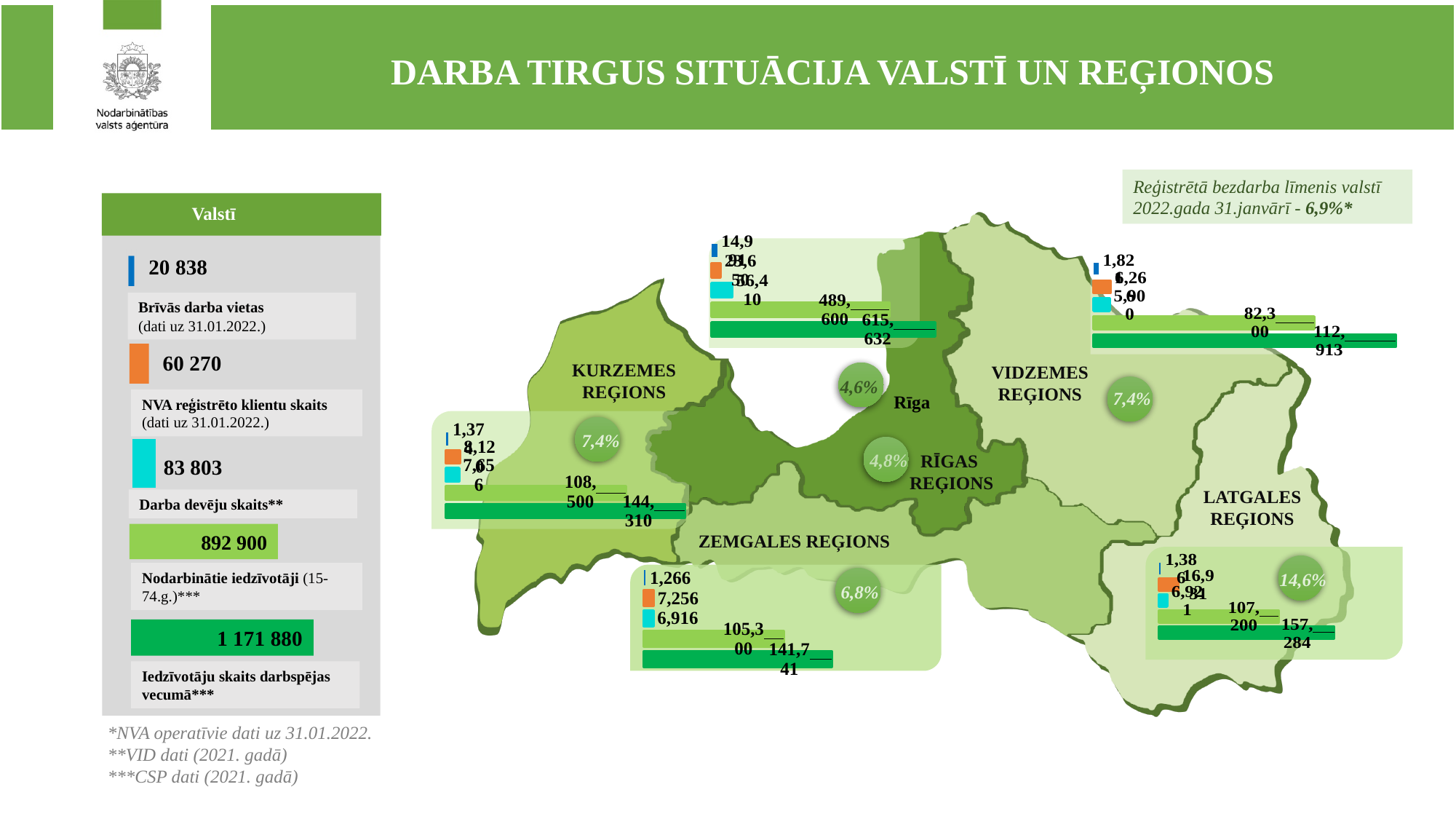
In the 'Valstī' chart on the left, what is the value for NVA reģistrēto klientu skaits? 60 270 In the Zemgales reģions chart on the map, what is the value of the orange bar? 7,256 On the map, which region shows the highest registered unemployment rate in its circle? Latgales reģions (14,6%) In the 'Valstī' chart on the left, what is the value for Nodarbinātie iedzīvotāji (15-74 g.)? 892 900 What kind of chart is the 'Valstī' chart on the left? bar chart In the 'Valstī' chart on the left, what is the value for Brīvās darba vietas? 20 838 In the Zemgales reģions chart on the map, what is the value of the longest (dark green) bar? 141,741 In the 'Valstī' chart on the left, what is the value for Darba devēju skaits? 83 803 In the 'Valstī' chart on the left, what is the difference between Darba devēju skaits and NVA reģistrēto klientu skaits? 23 533 In the 'Valstī' chart on the left, which category has the lowest value? Brīvās darba vietas In the 'Valstī' chart on the left, how many categories are shown? 5 In the 'Valstī' chart on the left, which category has the highest value? Iedzīvotāju skaits darbspējas vecumā